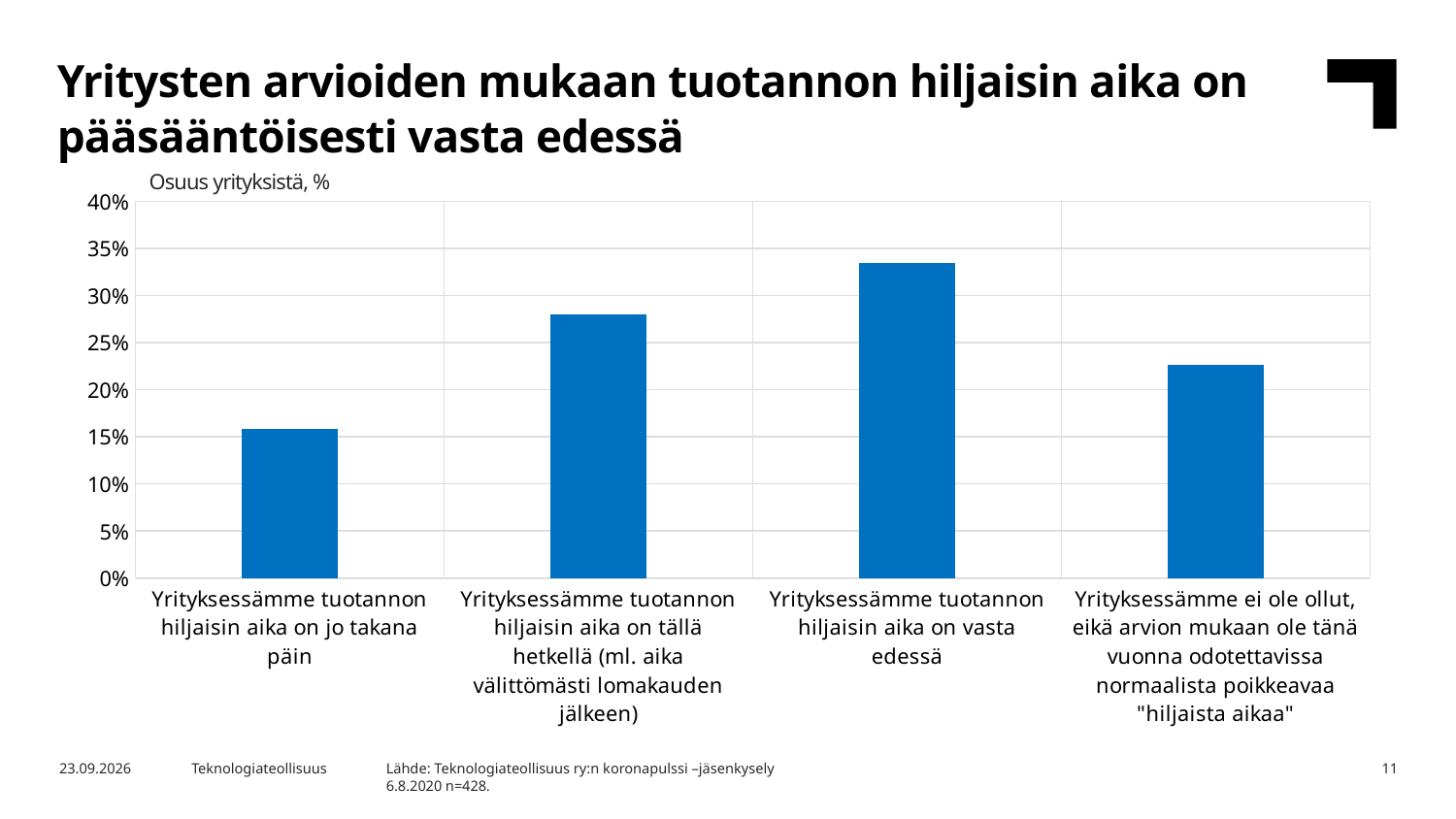
Is the value for "Yrityksessämme tuotannon hiljaisin aika on jo takana päin" greater or less than 20%? less What type of chart is shown on the slide? bar chart Which is larger: the share for "hiljaisin aika on jo takana päin" or the share for "hiljaisin aika on vasta edessä"? Yrityksessämme tuotannon hiljaisin aika on vasta edessä Is the value for "Yrityksessämme tuotannon hiljaisin aika on vasta edessä" greater or less than 30%? greater What is the maximum value shown on the vertical axis? 40% What is the label shown above the vertical axis of the chart? Osuus yrityksistä, % Is the value for "Yrityksessämme tuotannon hiljaisin aika on tällä hetkellä (ml. aika välittömästi lomakauden jälkeen)" greater or less than 25%? greater Which category has the lowest share of companies? Yrityksessämme tuotannon hiljaisin aika on jo takana päin Which category has the highest share of companies? Yrityksessämme tuotannon hiljaisin aika on vasta edessä Which is larger: the share for "hiljaisin aika on tällä hetkellä" or the share for "ei ole ollut, eikä ole odotettavissa hiljaista aikaa"? Yrityksessämme tuotannon hiljaisin aika on tällä hetkellä (ml. aika välittömästi lomakauden jälkeen) How many categories (bars) does the chart show? 4